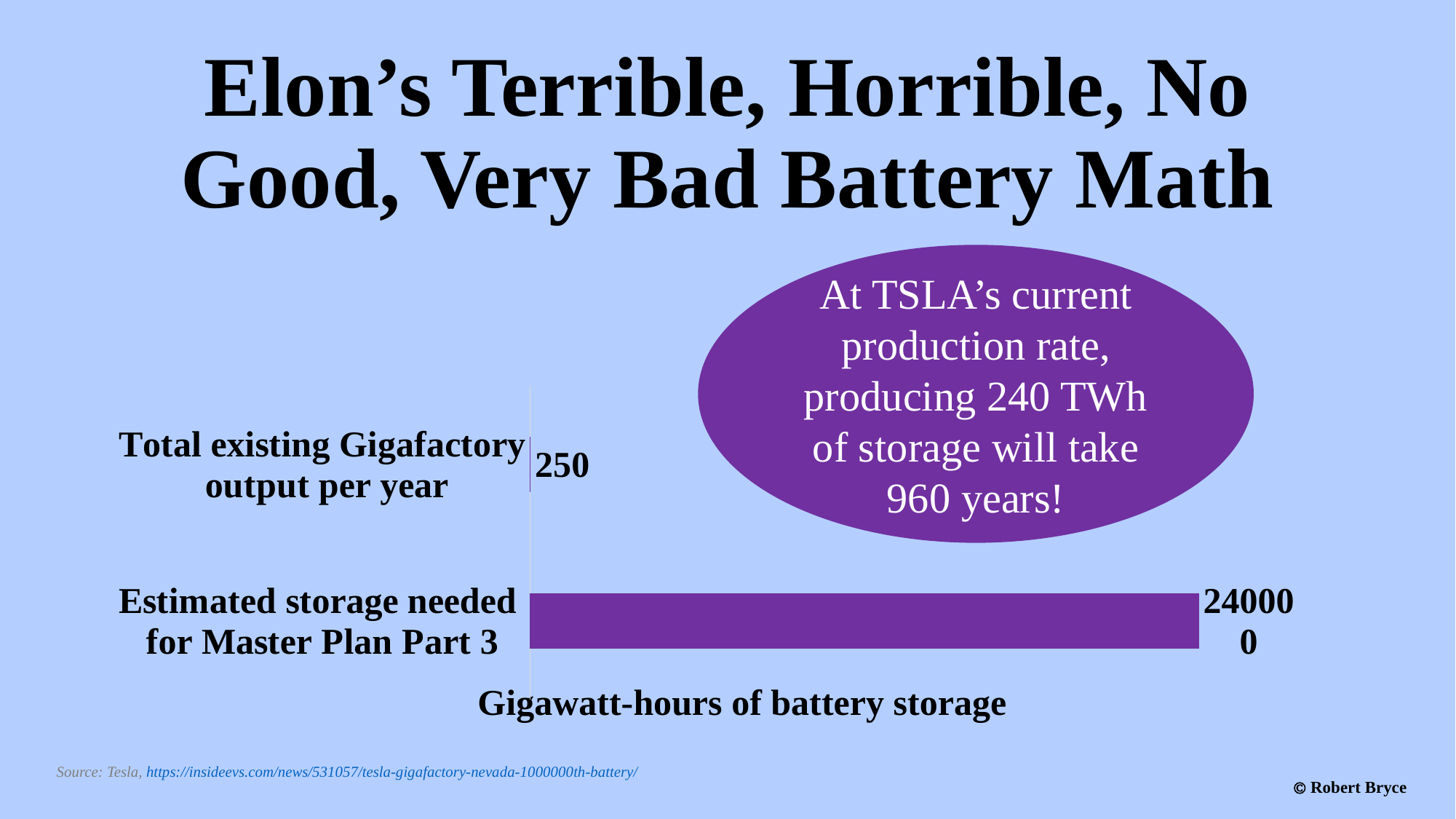
What is the axis title shown below the bars? Gigawatt-hours of battery storage Which category has the highest value? Estimated storage needed for Master Plan Part 3 How many categories are shown in the chart? 2 What kind of chart is shown on the slide? Bar chart What is the value for Total existing Gigafactory output per year? 250 What is the difference between the Estimated storage needed for Master Plan Part 3 and the Total existing Gigafactory output per year? 239750 What is the value for Estimated storage needed for Master Plan Part 3? 240000 What colour are the bars in the chart? Purple Which is larger: Total existing Gigafactory output per year or Estimated storage needed for Master Plan Part 3? Estimated storage needed for Master Plan Part 3 Which category has the lowest value? Total existing Gigafactory output per year